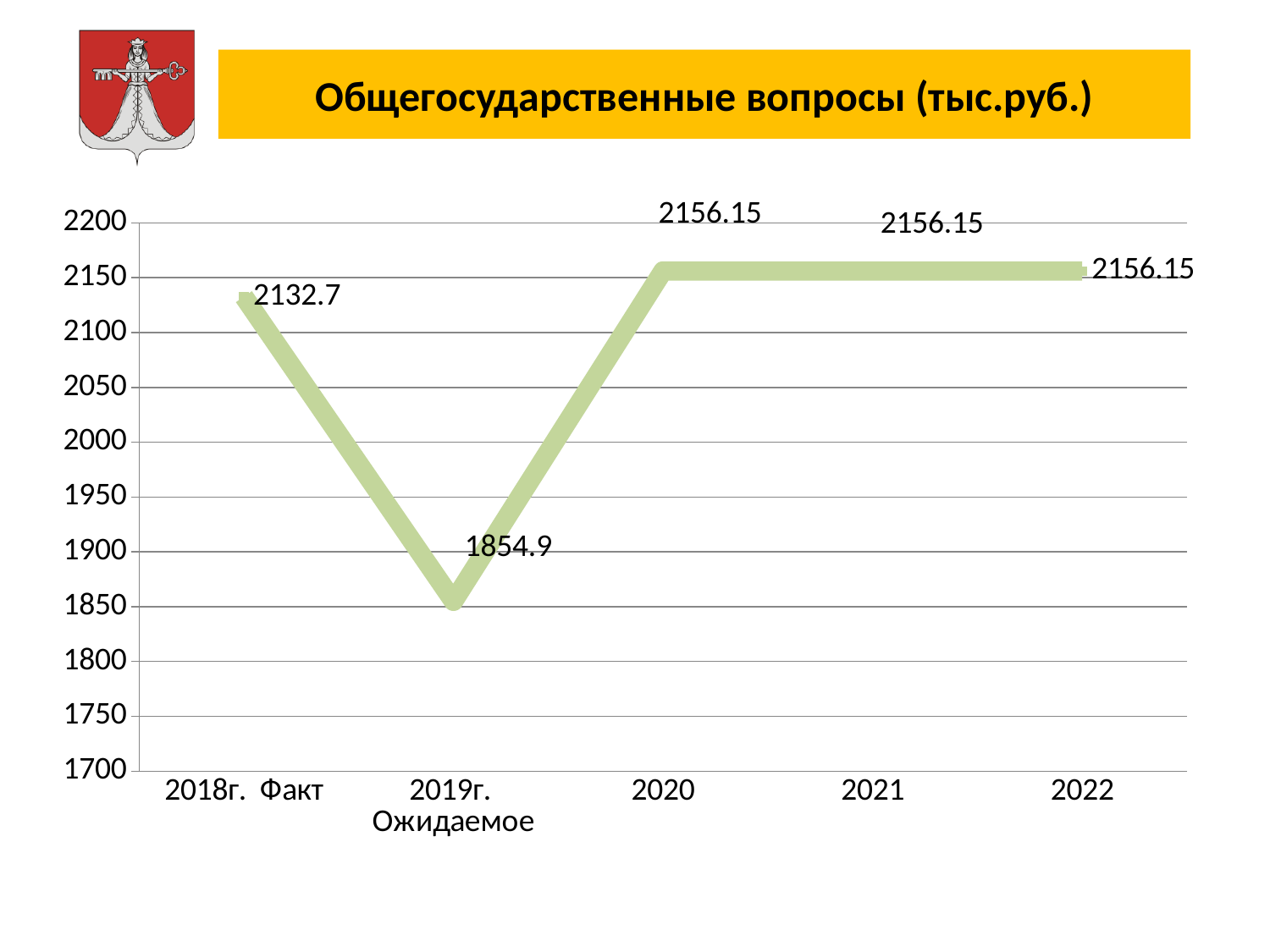
Which category has the lowest value? 2019г. Ожидаемое What is the value for 2018г. Факт? 2132.7 Which is larger, the value for 2018г. Факт or the value for 2020? 2020 What is the title of the chart? Общегосударственные вопросы (тыс.руб.) Do the values rise or fall from 2019г. Ожидаемое to 2020? rise What kind of chart is shown on the slide? line chart What is the value for 2019г. Ожидаемое? 1854.9 How many categories are shown on the x axis? 5 What is the difference between the values for 2018г. Факт and 2019г. Ожидаемое? 277.8 Is the value for 2019г. Ожидаемое greater or less than 1900? less What is the value for 2021? 2156.15 What is the difference between the values for 2020 and 2018г. Факт? 23.45